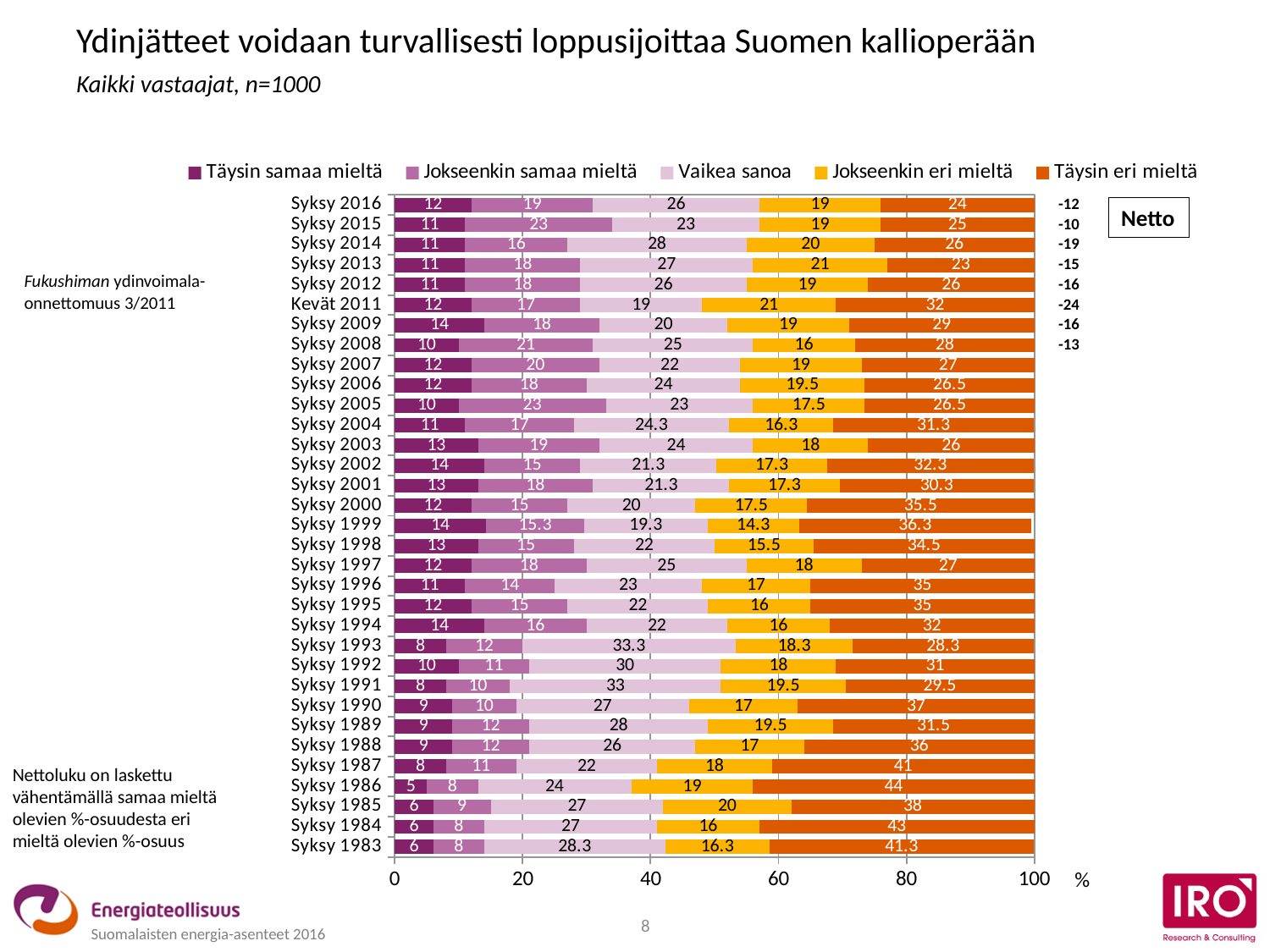
What is the value of 'Vaikea sanoa' for Syksy 1993? 33.3 What is the value of 'Täysin samaa mieltä' for Syksy 1986? 5 What is the difference between the 'Täysin eri mieltä' values for Syksy 1987 and Syksy 2016? 17 Which is larger: 'Jokseenkin samaa mieltä' for Syksy 2015 or for Syksy 2014? Syksy 2015 How many categories (survey rounds) are shown on the y axis? 33 What is the value of 'Jokseenkin eri mieltä' for Kevät 2011? 21 What is the total of the stacked bar for Syksy 2016? 100 How many series does the legend list? 5 What is the Netto value shown for Syksy 2016? -12 What is the value of 'Täysin eri mieltä' for Syksy 2016? 24 What kind of chart is shown on the slide? stacked bar chart Which category has the highest 'Täysin eri mieltä' value? Syksy 1986